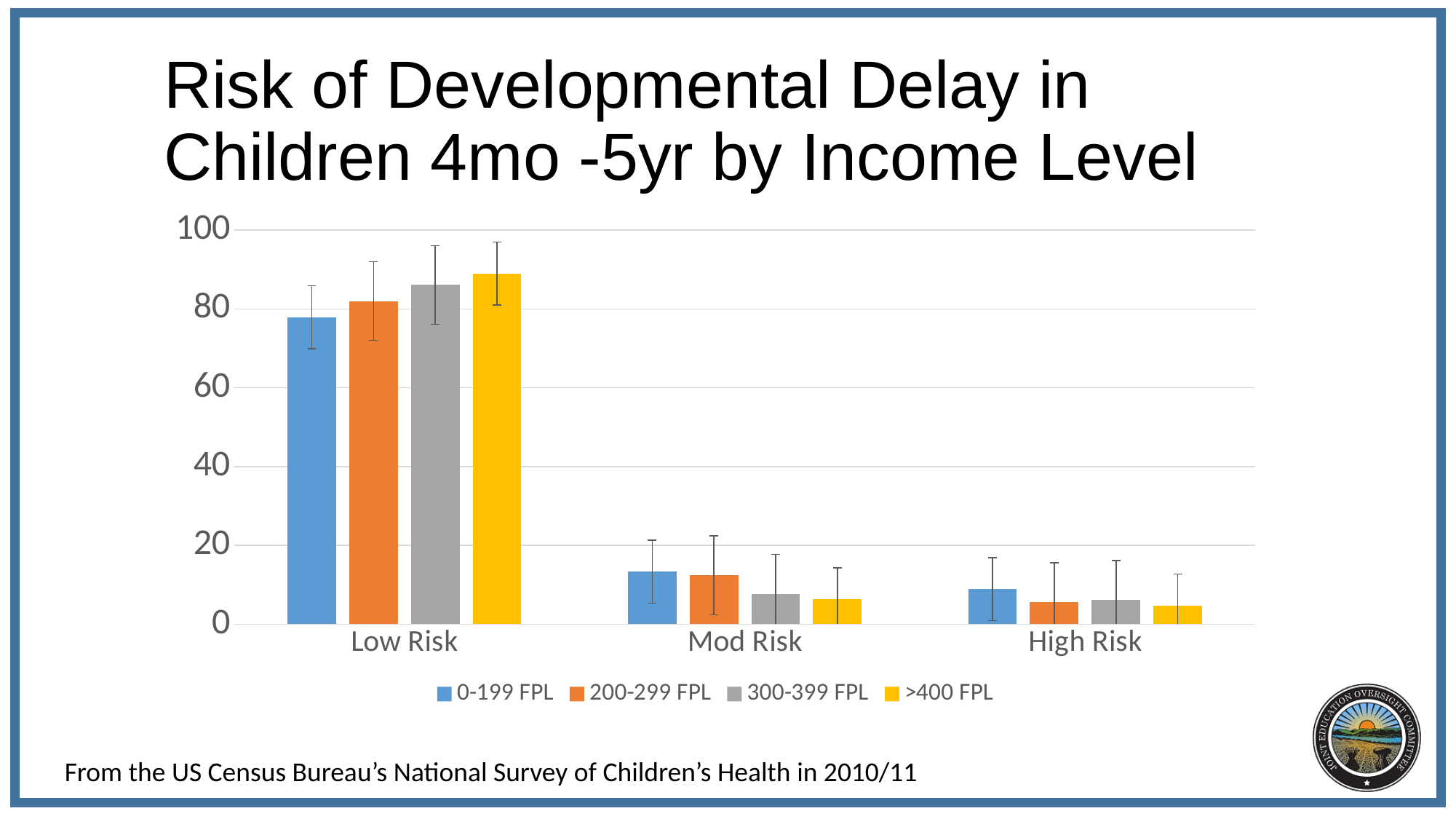
In the Low Risk category, which is larger: the value for 0-199 FPL or the value for >400 FPL? >400 FPL How many risk categories are shown on the x axis? 3 Which income level has the lowest value in the Low Risk category? 0-199 FPL Is the value for 0-199 FPL in the Mod Risk category greater or less than 20? less How many series does the legend list? 4 In the Mod Risk category, which is larger: the value for 0-199 FPL or the value for 300-399 FPL? 0-199 FPL Which income level has the highest value in the High Risk category? 0-199 FPL What colour represents the >400 FPL series in the legend? Yellow Which income level has the highest value in the Low Risk category? >400 FPL What kind of chart is shown on the slide? Bar chart Do the values for 0-199 FPL rise or fall from Low Risk to High Risk? fall Is the value for >400 FPL in the Low Risk category greater or less than 80? greater